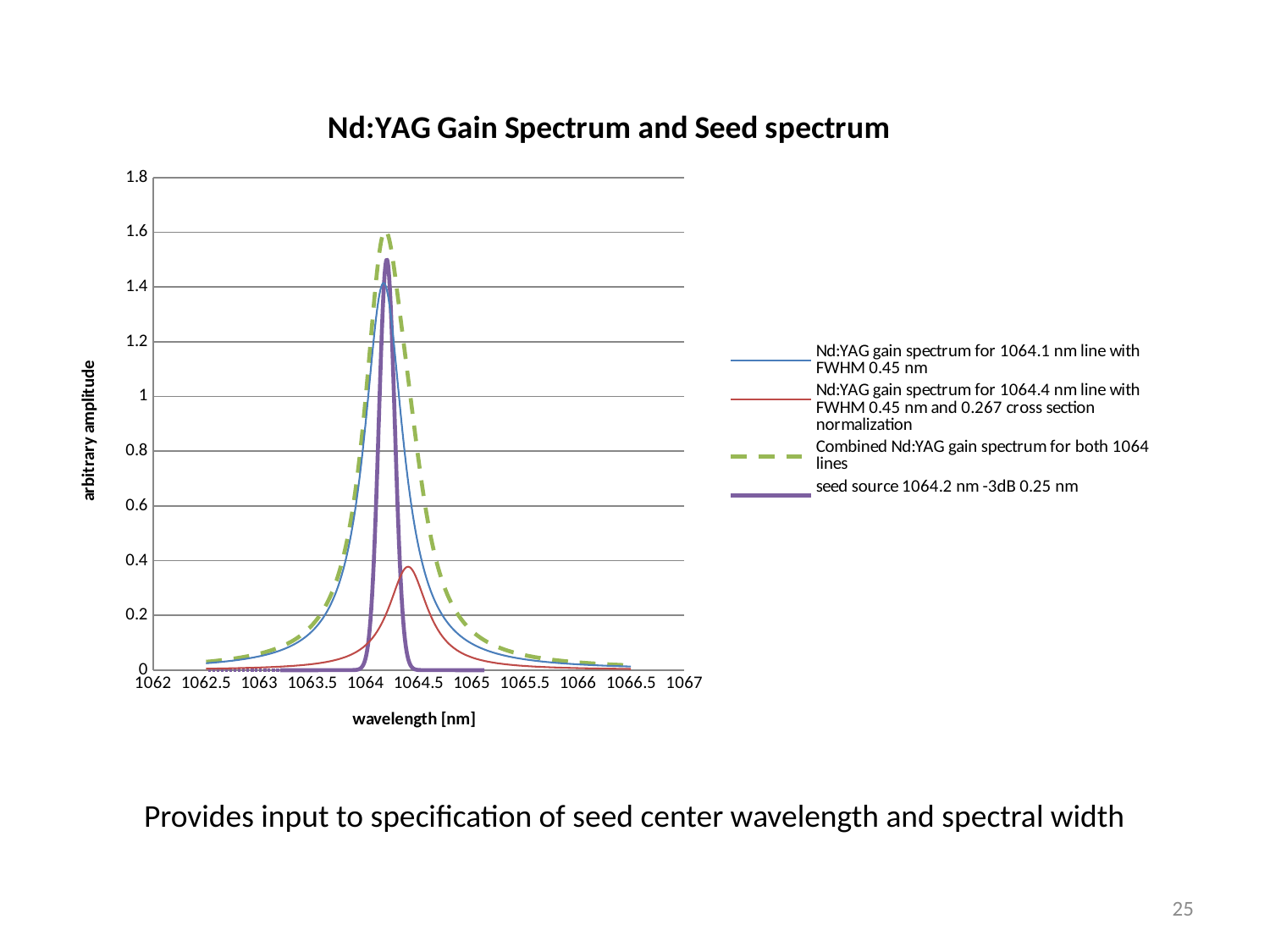
Is the peak value of the Nd:YAG gain spectrum for the 1064.4 nm line greater or less than 0.6? less Does the Nd:YAG gain spectrum for the 1064.1 nm line rise or fall between 1064.5 nm and 1066 nm? fall What is the highest value shown on the y axis? 1.8 How many series does the legend list? 4 Which series has the lowest peak amplitude? Nd:YAG gain spectrum for 1064.4 nm line with FWHM 0.45 nm and 0.267 cross section normalization What is the label of the x axis? wavelength [nm] Is the peak value of the combined Nd:YAG gain spectrum greater or less than 1.4? greater Which has a higher peak: the Nd:YAG gain spectrum for the 1064.1 nm line or the Nd:YAG gain spectrum for the 1064.4 nm line? Nd:YAG gain spectrum for 1064.1 nm line What kind of chart is shown on the slide? line chart Is the peak value of the seed source 1064.2 nm series greater or less than 1.2? greater Which series reaches the highest peak amplitude? Combined Nd:YAG gain spectrum for both 1064 lines What is the title of the chart? Nd:YAG Gain Spectrum and Seed spectrum